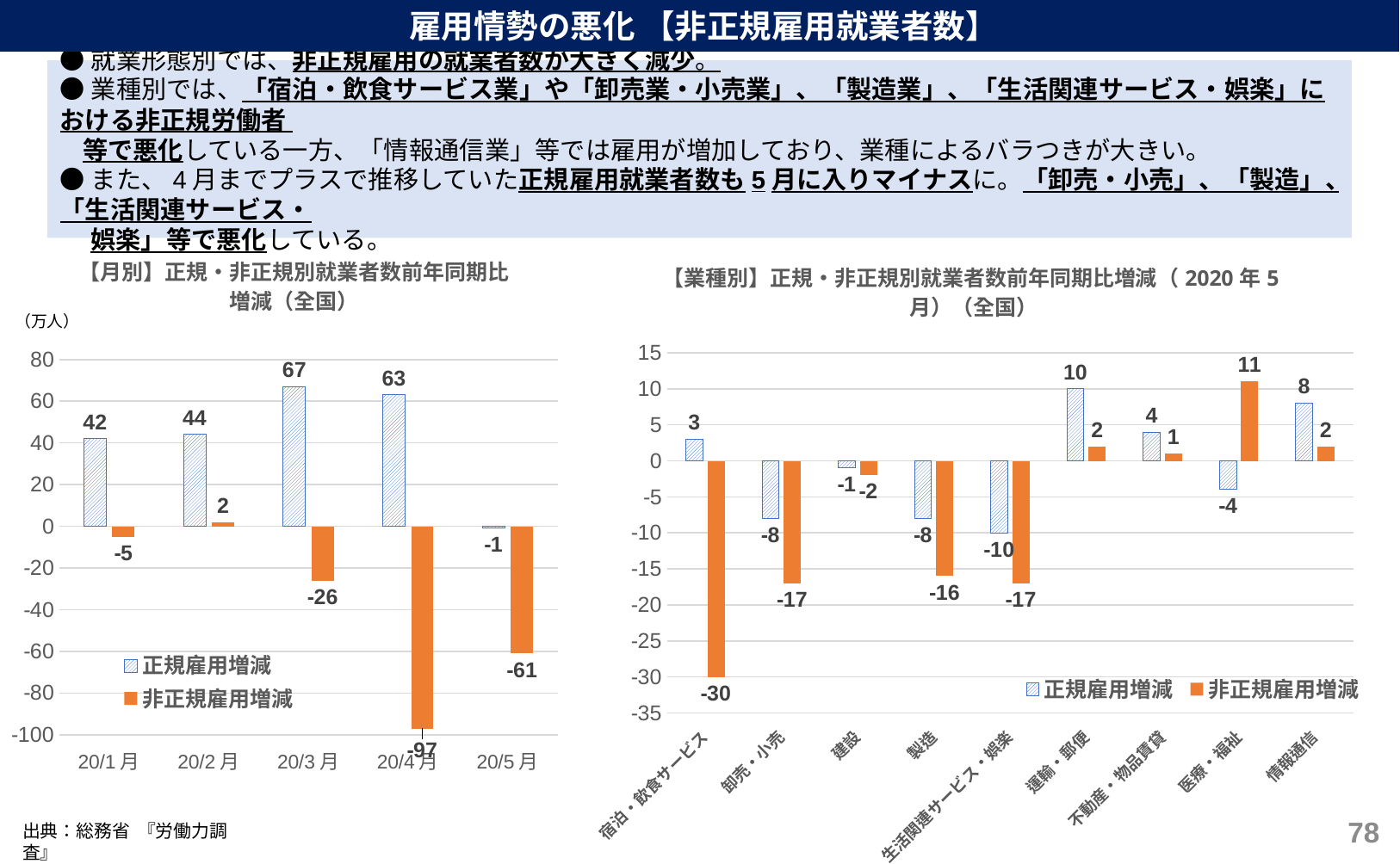
In the right chart (【業種別】), which is larger: 非正規雇用増減 for 卸売・小売 or for 製造? 製造 In the left chart (【月別】), what is the value of 非正規雇用増減 for 20/4月? -97 In the left chart (【月別】), which month has the lowest value for 非正規雇用増減? 20/4月 In the left chart (【月別】), what is the difference between 正規雇用増減 and 非正規雇用増減 for 20/5月? 60 In the right chart (【業種別】), which industry has the highest value for 非正規雇用増減? 医療・福祉 In the right chart (【業種別】), how many industries are shown on the x axis? 9 In the left chart (【月別】), what kind of chart is used? Bar chart In the left chart (【月別】), what is the value of 正規雇用増減 for 20/3月? 67 In the right chart (【業種別】), which industry has the highest value for 正規雇用増減? 運輸・郵便 In the left chart (【月別】), how many months are shown on the x axis? 5 In the right chart (【業種別】), what is the value of 非正規雇用増減 for 宿泊・飲食サービス? -30 In the right chart (【業種別】), how many series does the legend list? 2